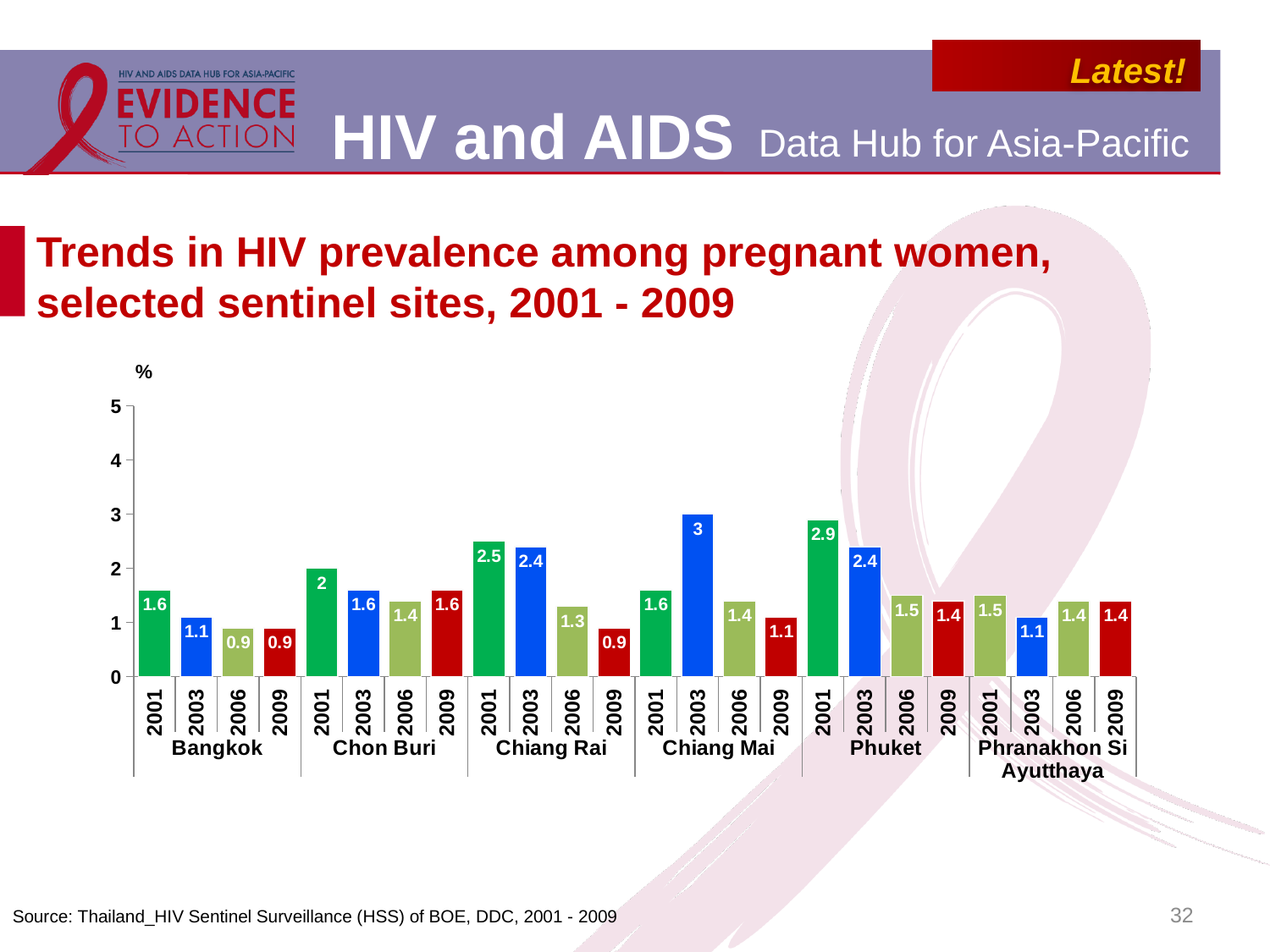
Which is larger: the 2001 value for Chiang Rai or the 2001 value for Chon Buri? Chiang Rai What was the HIV prevalence in Phuket in 2001? 2.9 What kind of chart is used on this slide? Bar chart Is the value for Chiang Mai in 2003 greater or less than 2? greater What value is shown for Chiang Mai in 2003? 3 Do the values for Chiang Rai rise or fall from 2001 to 2009? Fall What was the HIV prevalence among pregnant women in Bangkok in 2001? 1.6 How many sentinel sites are shown on the chart? 6 Which site and year has the highest HIV prevalence on the chart? Chiang Mai, 2003 What is the difference between the Phuket values for 2001 and 2009? 1.5 What value is shown for Phranakhon Si Ayutthaya in 2003? 1.1 Within Chiang Rai, which year has the lowest value? 2009